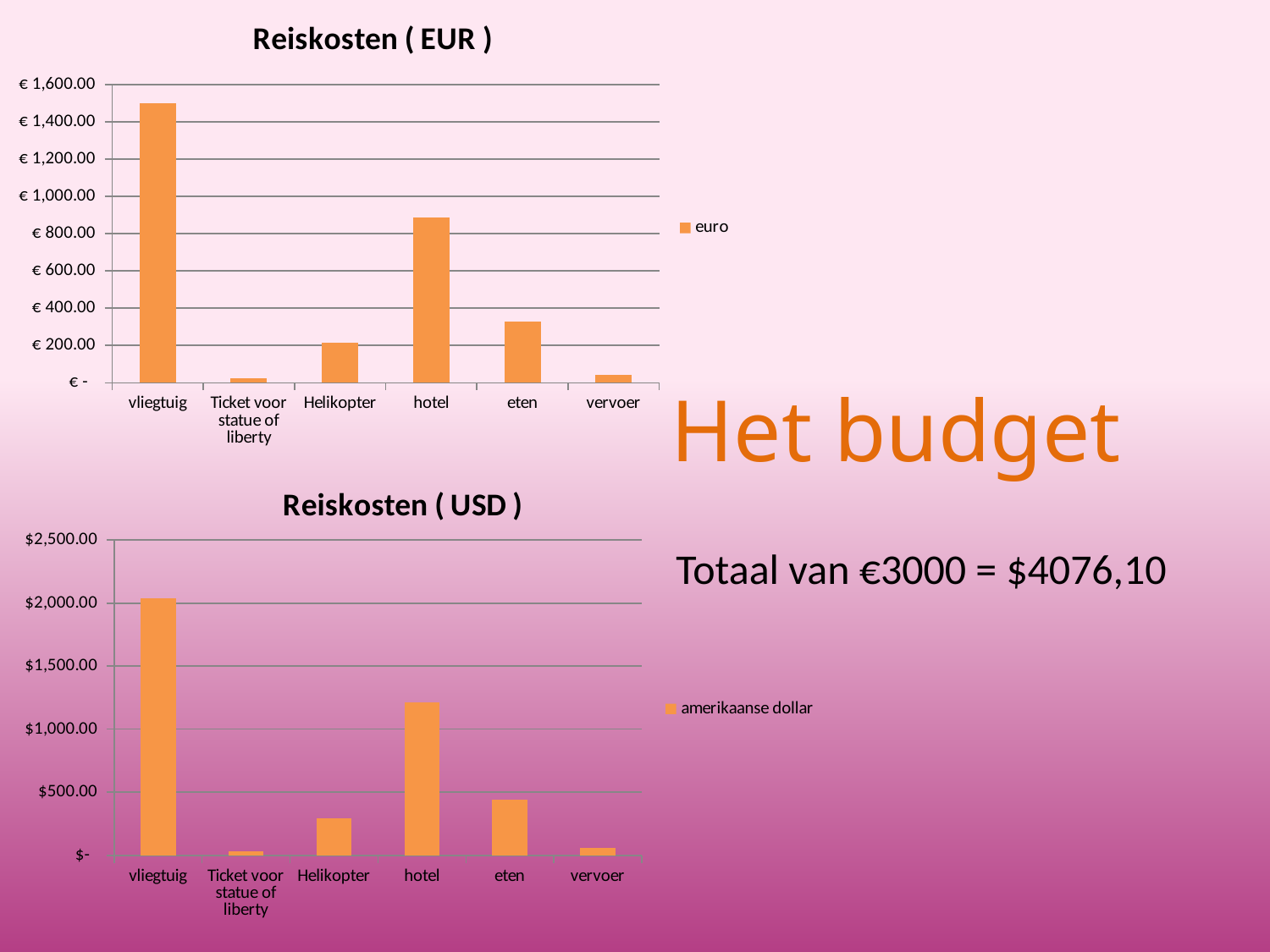
In the 'Reiskosten ( EUR )' chart, which is larger, the value for hotel or the value for eten? hotel In the 'Reiskosten ( EUR )' chart, which category has the highest value? vliegtuig What type of chart is the 'Reiskosten ( EUR )' chart? bar chart In the 'Reiskosten ( USD )' chart, which is larger, the value for Helikopter or the value for eten? eten In the 'Reiskosten ( EUR )' chart, is the value for eten greater or less than € 400.00? less In the 'Reiskosten ( EUR )' chart, is the value for vliegtuig greater or less than € 1,400.00? greater How many categories are shown on the x axis of the 'Reiskosten ( EUR )' chart? 6 In the 'Reiskosten ( USD )' chart, which category has the highest value? vliegtuig In the 'Reiskosten ( USD )' chart, is the value for hotel greater or less than $1,000.00? greater How many series does the legend of the 'Reiskosten ( USD )' chart list? 1 What is the legend entry of the 'Reiskosten ( USD )' chart? amerikaanse dollar